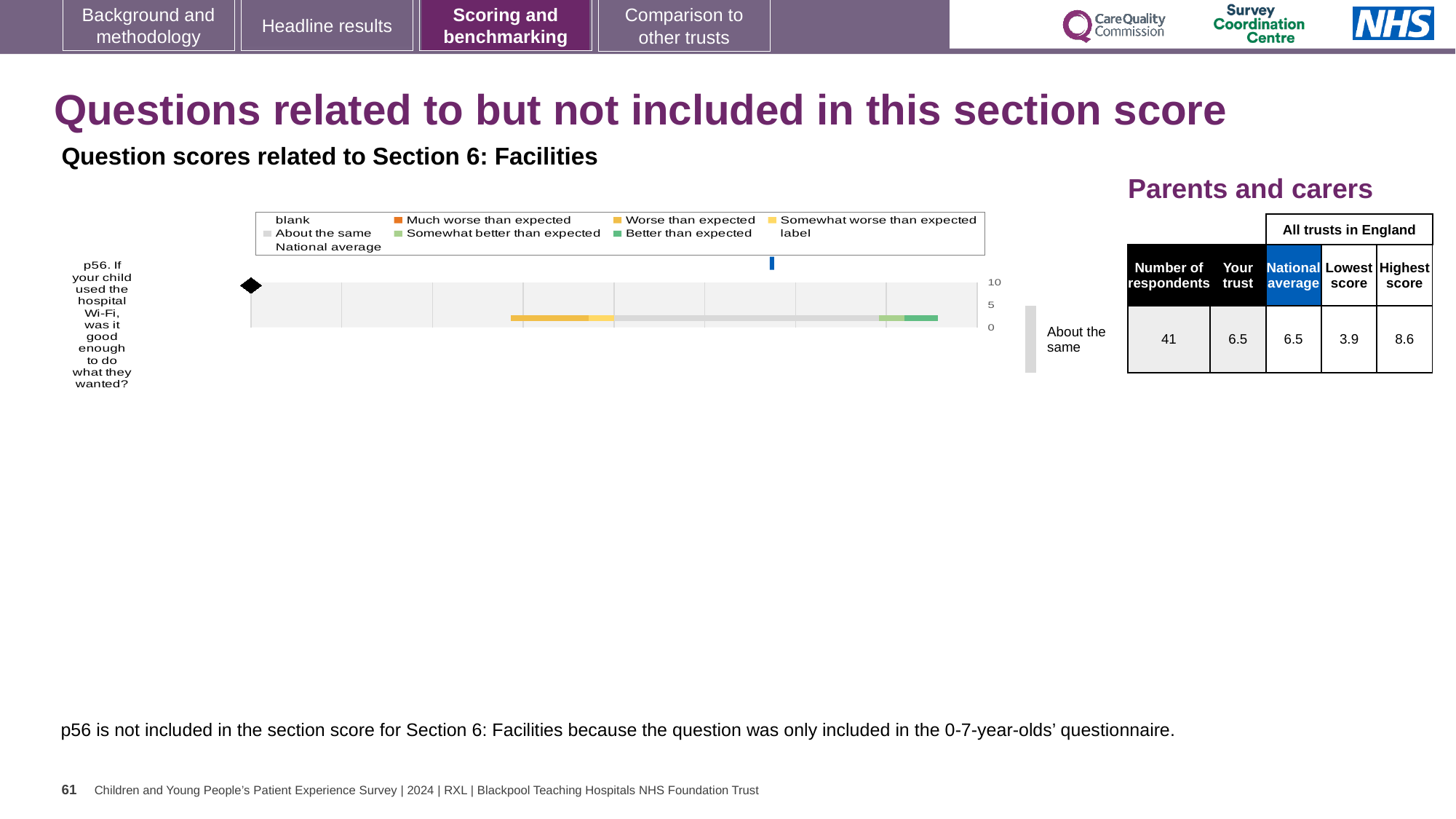
What is the lowest score among all trusts in England for p56? 3.9 Which question is plotted in the chart? p56. If your child used the hospital Wi-Fi, was it good enough to do what they wanted? What is the 'Your trust' score for p56? 6.5 What kind of chart is used to show the p56 question score? Bar chart What is the highest value shown on the chart's score axis? 10 How many questions are plotted in the chart? 1 Which benchmark category is the trust's p56 result placed in? About the same Is the trust's score for p56 greater or less than 5? greater What is the national average score for p56? 6.5 How many respondents answered p56? 41 What is the difference between the highest and lowest trust scores for p56? 4.7 What is the highest score among all trusts in England for p56? 8.6